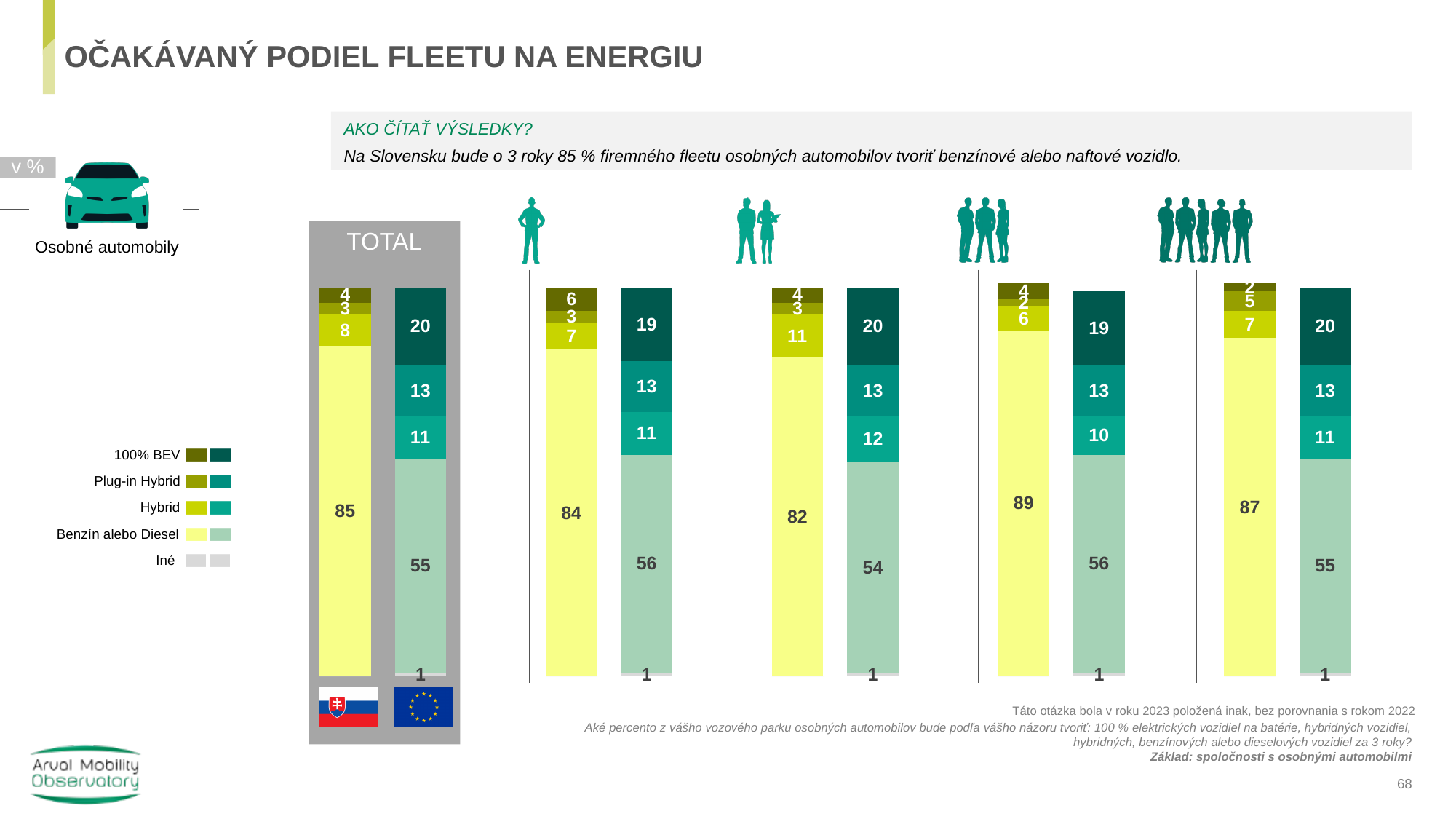
In the second group to the right of TOTAL, what is the Hybrid value for the EU bar? 12 Among the Slovak (yellow) bars, which group has the highest Benzín alebo Diesel value? The third group to the right of TOTAL (89) In the TOTAL section, what is the Benzín alebo Diesel value for the Slovak bar? 85 What is the title of the slide? OČAKÁVANÝ PODIEL FLEETU NA ENERGIU In the rightmost group (largest company icon), what is the Benzín alebo Diesel value for the Slovak bar? 87 How many series does the legend list? 5 What kind of chart is shown on the slide? Stacked bar chart In the TOTAL section, what is the 100% BEV value for the EU bar? 20 In the TOTAL section, what is the difference between the Slovak and EU Benzín alebo Diesel values? 30 In the TOTAL section, which bar has the larger Hybrid value, the Slovak bar or the EU bar? EU bar Among the Slovak (yellow) bars, which group has the lowest Benzín alebo Diesel value? The second group to the right of TOTAL (82) What is the total of the Slovak bar in the TOTAL section? 100